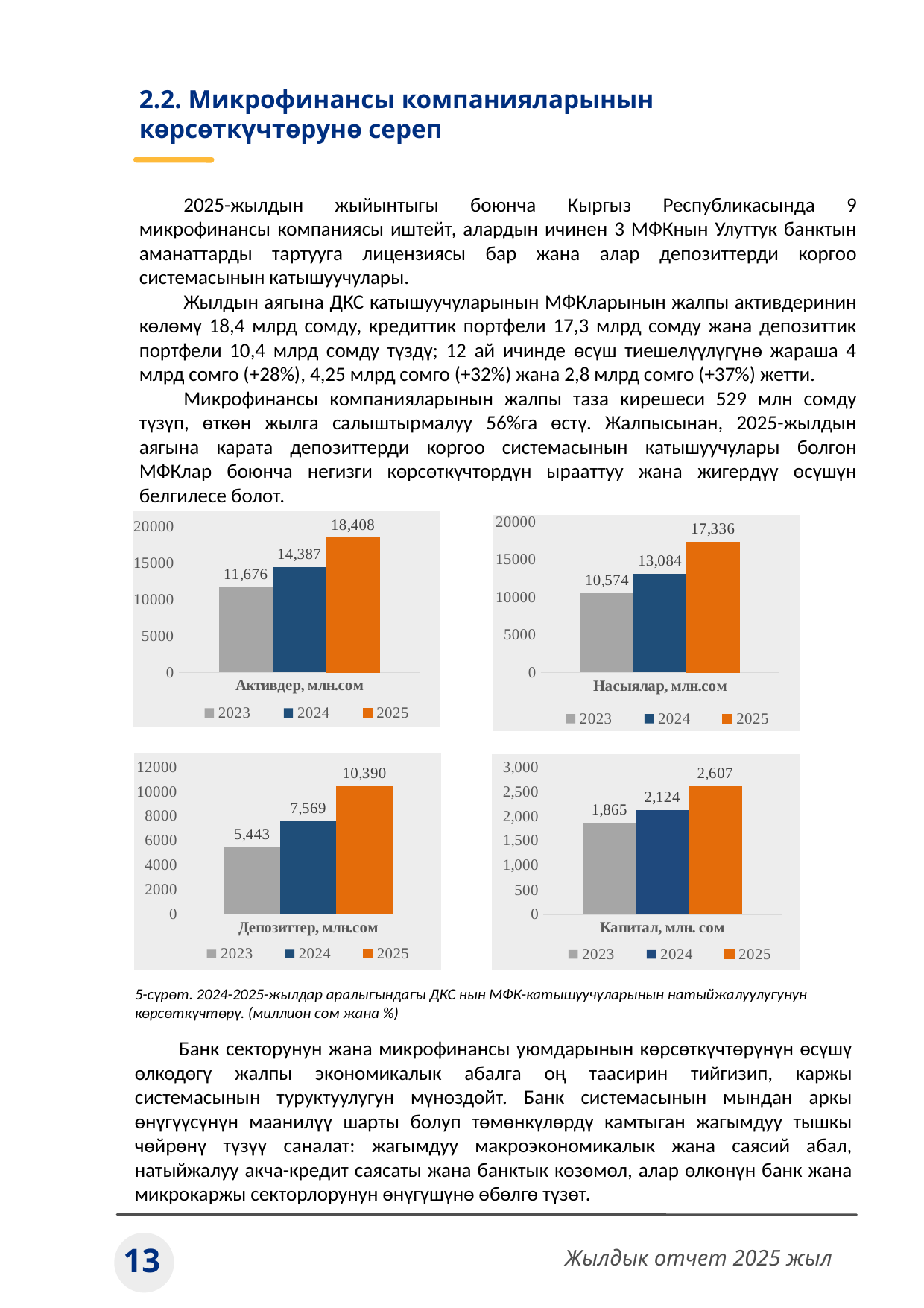
In the 'Активдер, млн.сом' chart, what is the value for 2025? 18,408 In the 'Насыялар, млн.сом' chart, what is the value for 2023? 10,574 How many series does the legend of the 'Активдер, млн.сом' chart list? 3 In the 'Капитал, млн. сом' chart, what is the value for 2025? 2,607 In the 'Капитал, млн. сом' chart, which year has the highest value? 2025 In the 'Депозиттер, млн.сом' chart, what is the difference between the 2024 and 2023 values? 2,126 In the 'Насыялар, млн.сом' chart, what is the difference between the 2025 and 2024 values? 4,252 In the 'Капитал, млн. сом' chart, which is larger: the value for 2023 or the value for 2024? 2024 In the 'Активдер, млн.сом' chart, which year has the lowest value? 2023 In the 'Депозиттер, млн.сом' chart, what is the value for 2024? 7,569 What kind of chart is the 'Насыялар, млн.сом' chart? bar chart In the 'Депозиттер, млн.сом' chart, do the values rise or fall from 2023 to 2025? rise